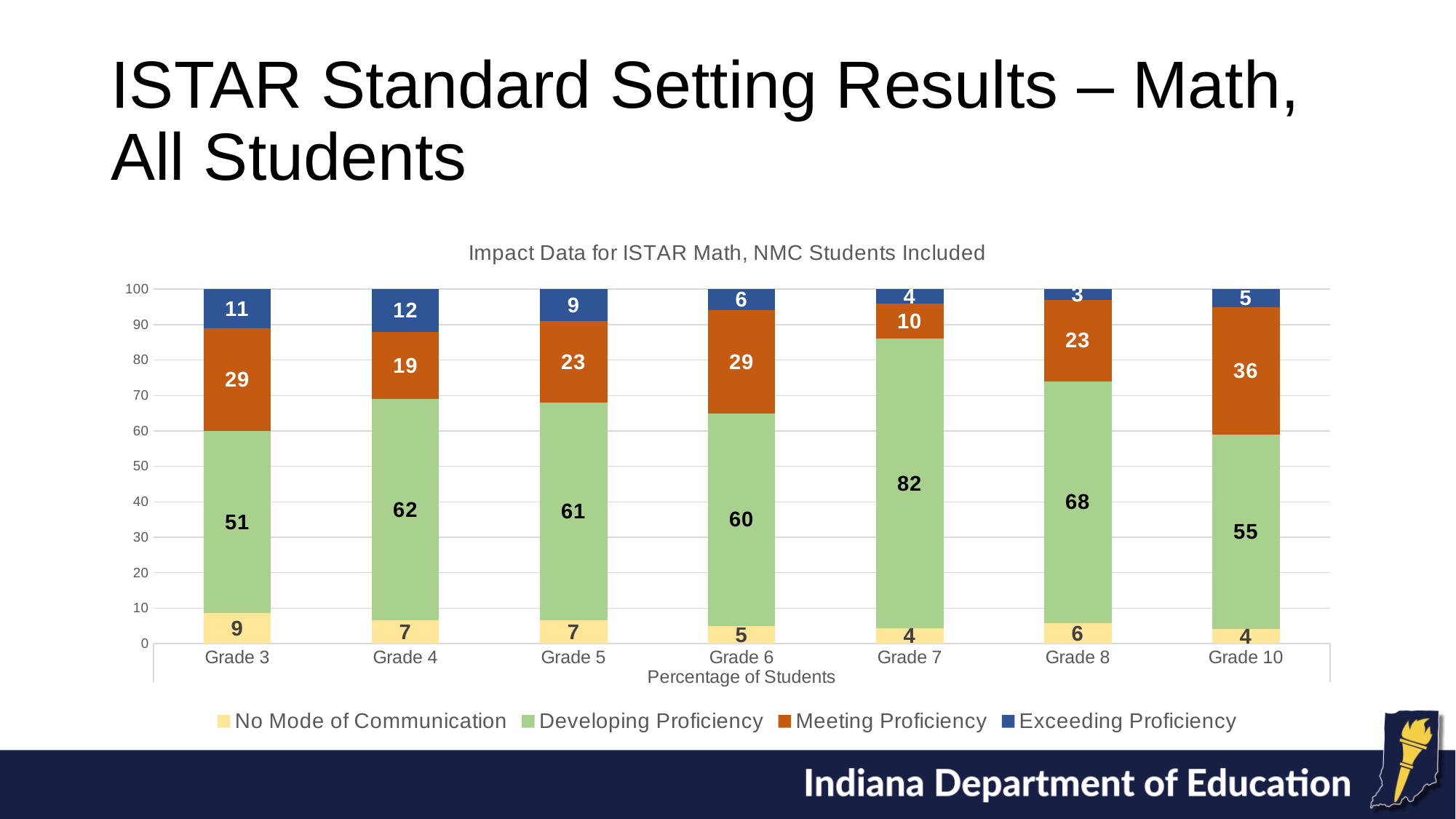
Which is larger, the Meeting Proficiency value for Grade 3 or for Grade 4? Grade 3 What is the title of the chart? Impact Data for ISTAR Math, NMC Students Included What is the Meeting Proficiency value for Grade 10? 36 How many series does the legend list? 4 What is the difference between the Meeting Proficiency values for Grade 10 and Grade 7? 26 Which grade has the highest Developing Proficiency value? Grade 7 How many grades are shown on the x axis? 7 What kind of chart is shown on the slide? Stacked bar chart What is the No Mode of Communication value for Grade 3? 9 What is the Developing Proficiency value for Grade 7? 82 Which grade has the lowest Exceeding Proficiency value? Grade 8 What is the Exceeding Proficiency value for Grade 4? 12